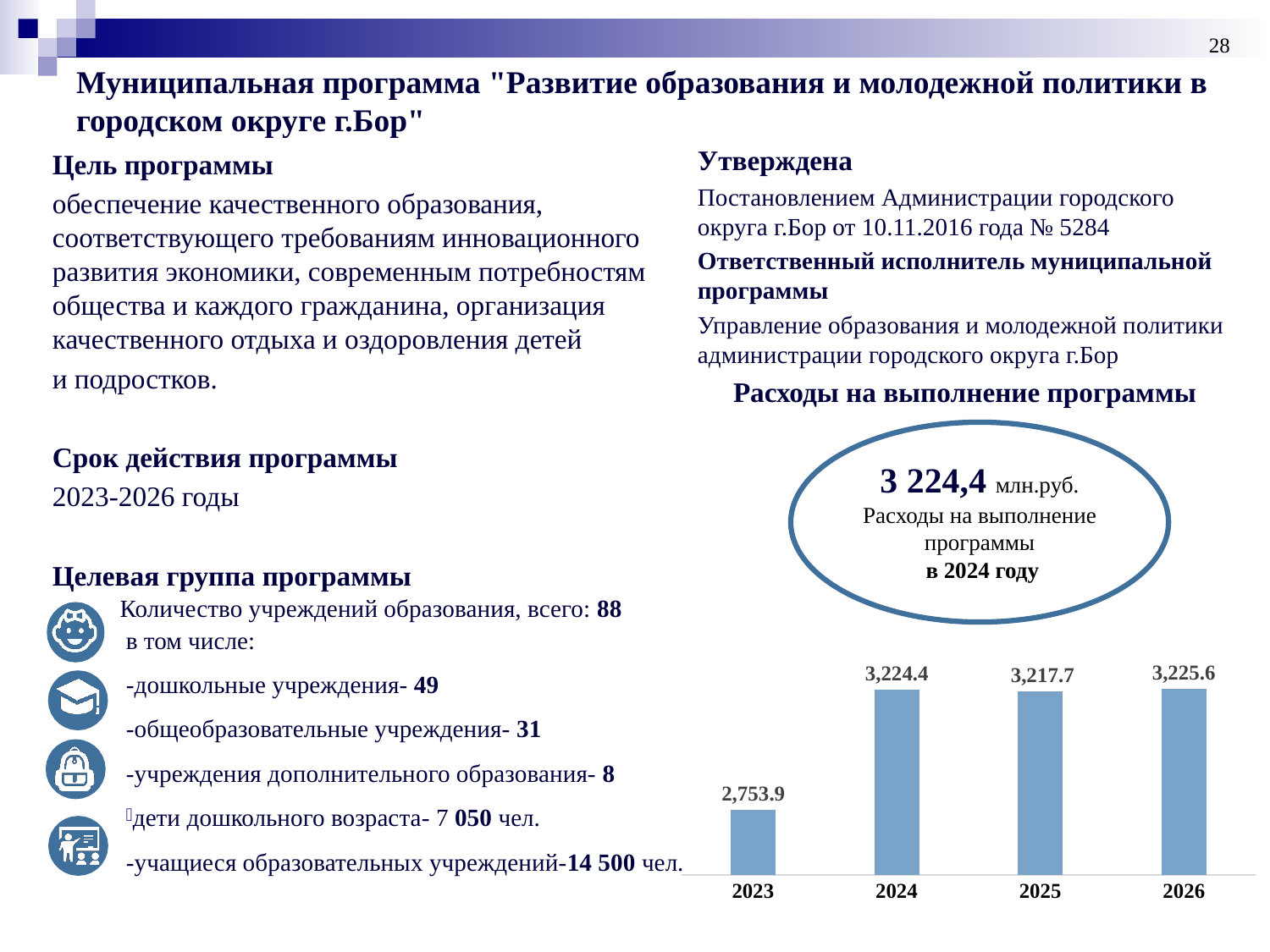
Does the value rise or fall from 2023 to 2024 in the chart? rise What is the value shown for 2025 in the chart? 3,217.7 What type of chart is shown under the heading "Расходы на выполнение программы"? bar chart What is the value shown for 2024 in the chart? 3,224.4 How many bars (years) are plotted in the chart? 4 What is the value shown for 2026 in the chart? 3,225.6 Which is larger in the chart, the value for 2023 or the value for 2025? 2025 Which year has the lowest value in the chart? 2023 What is the difference between the values for 2026 and 2025 in the chart? 7.9 What is the difference between the values for 2024 and 2023 in the chart? 470.5 What is the value shown for 2023 in the chart? 2,753.9 According to the data labels, which year has the highest value in the chart? 2026